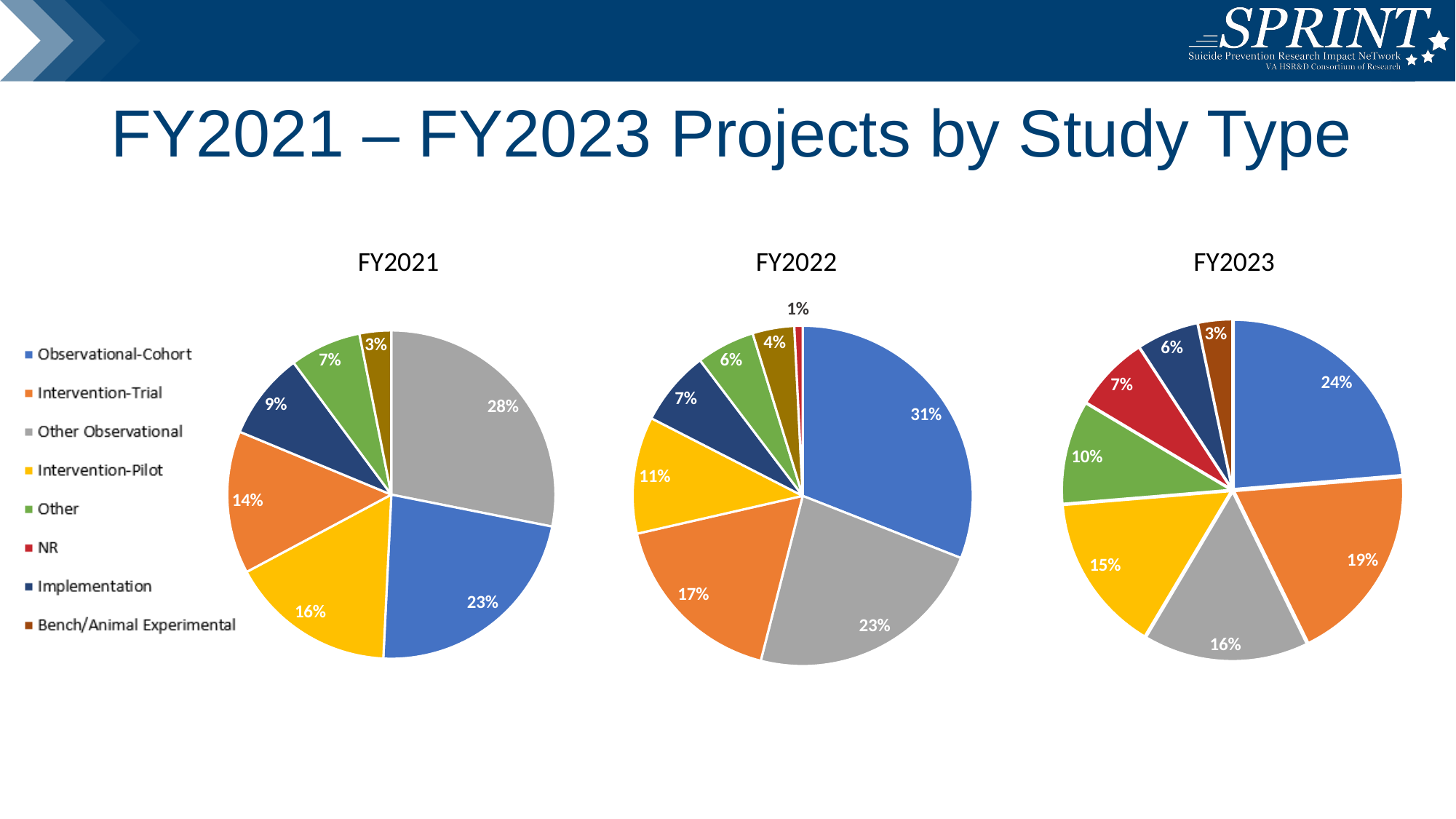
In the FY2021 pie chart, what share is Other Observational? 28% In the FY2022 pie chart, what share is Observational-Cohort? 31% How many slices does the FY2021 pie chart have? 7 In the FY2023 pie chart, which is larger, the Intervention-Pilot share or the Other share? Intervention-Pilot In the FY2022 pie chart, what is the difference between the Observational-Cohort share and the Other Observational share? 8% What kind of charts are shown on the slide? Pie charts In the FY2021 pie chart, what share is Implementation? 9% How many study types does the legend list? 8 In the FY2023 pie chart, which study type has the largest share? Observational-Cohort In the FY2022 pie chart, which study type has the smallest share? NR In the FY2021 pie chart, which study type has the largest share? Other Observational In the FY2023 pie chart, what share is Intervention-Trial? 19%